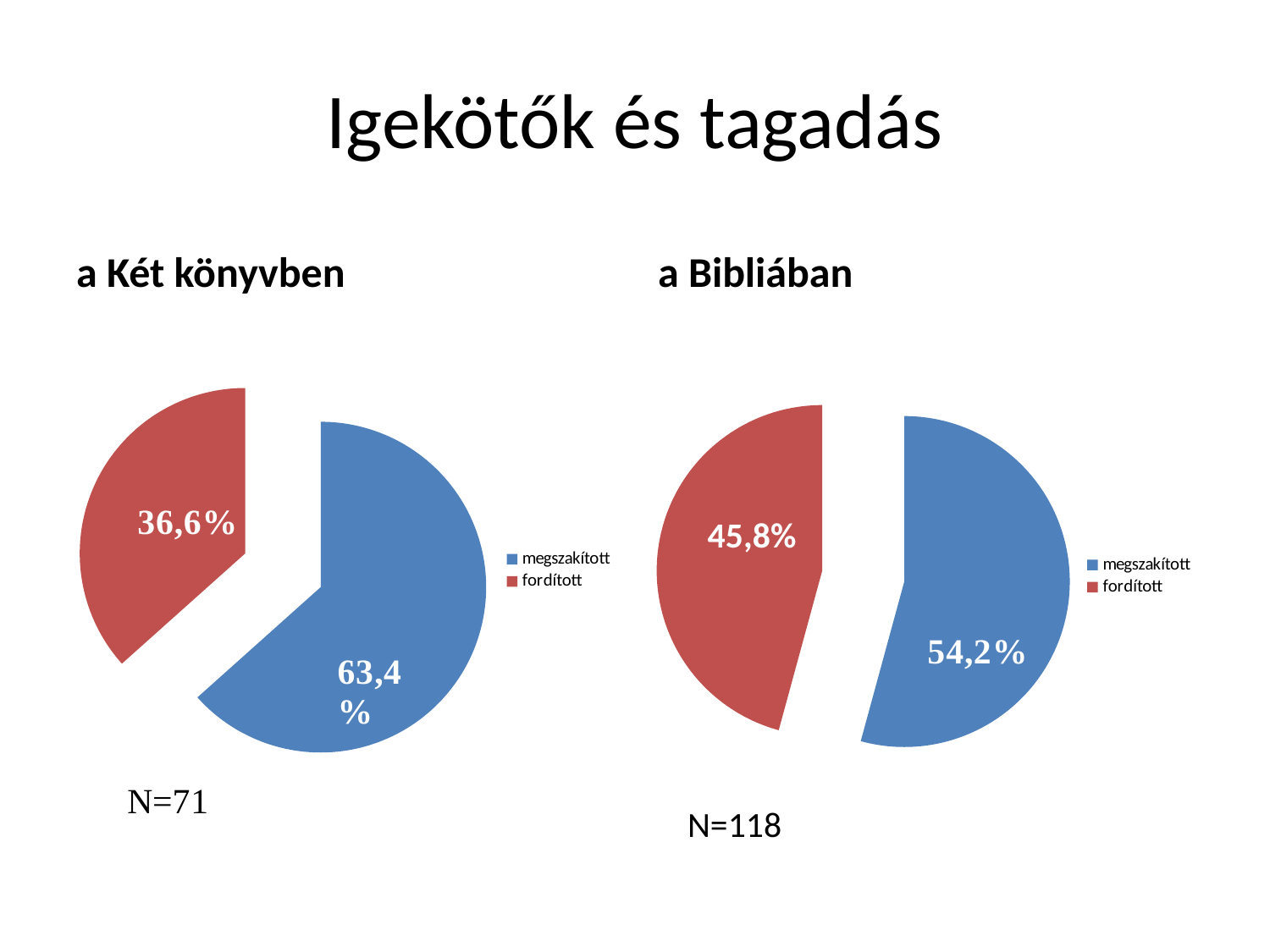
In the 'a Két könyvben' chart, which slice is the largest? megszakított How many entries does the legend of the 'a Két könyvben' chart list? 2 In the 'a Két könyvben' chart, what share does the 'fordított' slice have? 36,6% What kind of chart is used on the slide for 'a Bibliában'? Pie chart In the 'a Bibliában' chart, what colour is the 'fordított' slice? Red In the 'a Bibliában' chart, what share does the 'fordított' slice have? 45,8% In the 'a Bibliában' chart, which slice is the smallest? fordított Is the 'megszakított' share larger in the 'a Két könyvben' chart or in the 'a Bibliában' chart? a Két könyvben In the 'a Bibliában' chart, what is the difference between the 'megszakított' and 'fordított' shares? 8,4% In the 'a Bibliában' chart, what share does the 'megszakított' slice have? 54,2% In the 'a Két könyvben' chart, what share does the 'megszakított' slice have? 63,4% In the 'a Két könyvben' chart, what is the difference between the 'megszakított' and 'fordított' shares? 26,8%